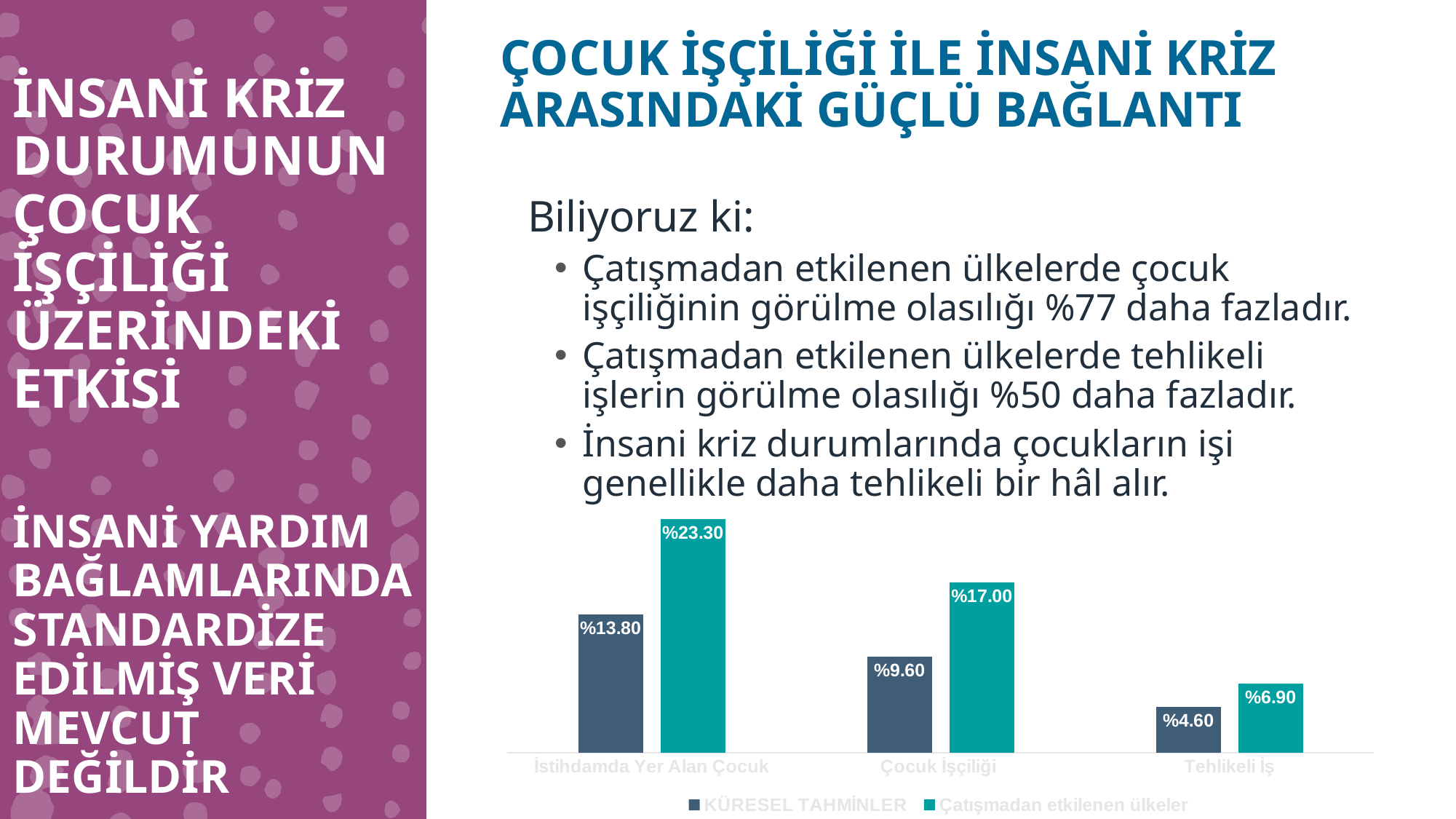
What kind of chart is shown on the slide? Bar chart Which category has the highest value for the Çatışmadan etkilenen ülkeler series? İstihdamda Yer Alan Çocuk What is the value for Çatışmadan etkilenen ülkeler in the Çocuk İşçiliği category? %17.00 What is the value for KÜRESEL TAHMİNLER in the İstihdamda Yer Alan Çocuk category? %13.80 What is the difference between the Çatışmadan etkilenen ülkeler and KÜRESEL TAHMİNLER values in the Çocuk İşçiliği category? %7.40 Which category has the lowest value for the KÜRESEL TAHMİNLER series? Tehlikeli İş In the İstihdamda Yer Alan Çocuk category, which series has the larger value? Çatışmadan etkilenen ülkeler What is the value for KÜRESEL TAHMİNLER in the Tehlikeli İş category? %4.60 What is the difference between the two series' values in the Tehlikeli İş category? %2.30 How many series does the chart legend list? 2 What is the value for Çatışmadan etkilenen ülkeler in the İstihdamda Yer Alan Çocuk category? %23.30 How many categories are shown on the x axis of the chart? 3